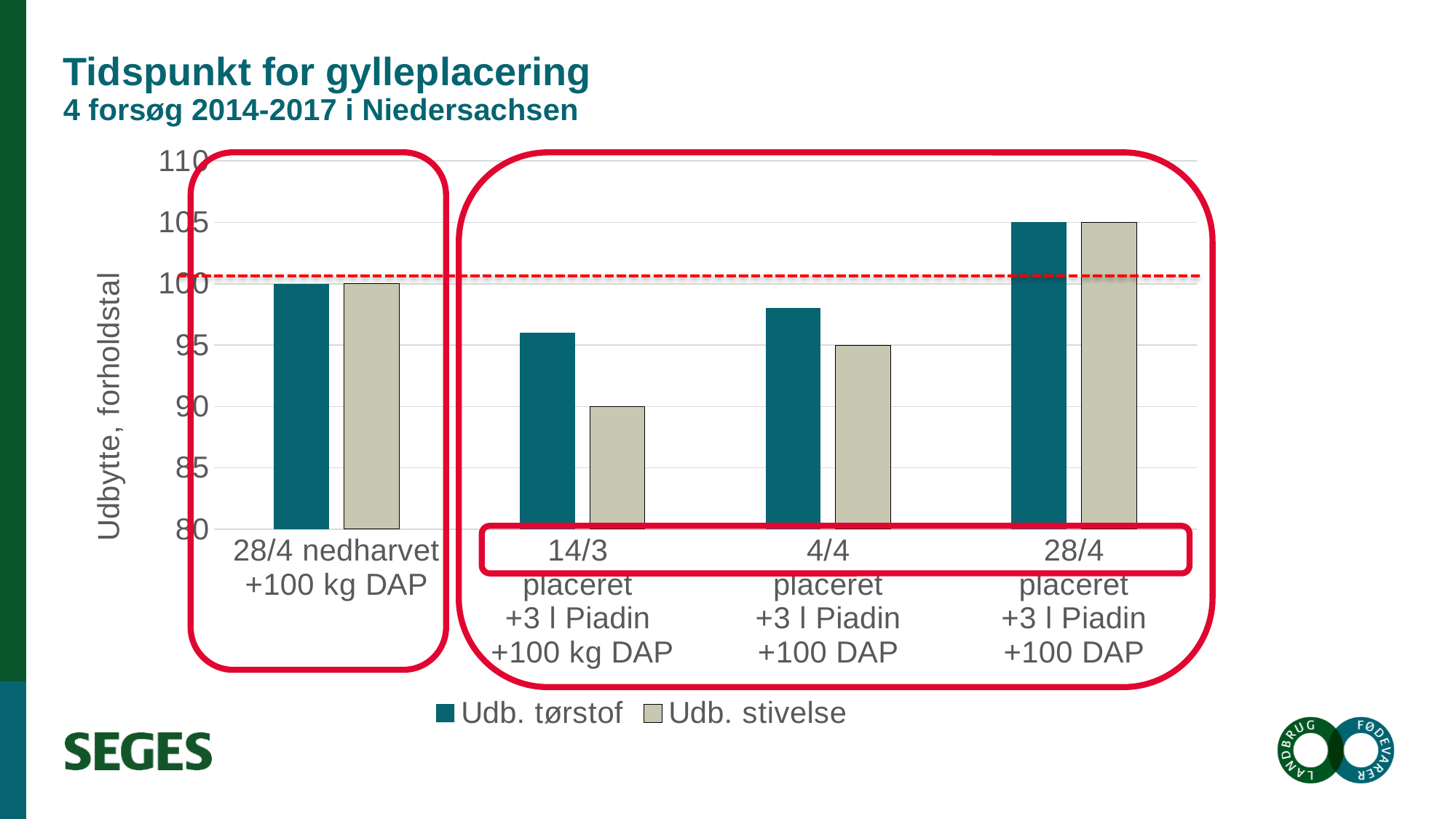
How many series does the legend list? 2 What is the value of Udb. stivelse for '14/3 placeret +3 l Piadin +100 kg DAP'? 90 Is the Udb. tørstof value for '14/3 placeret +3 l Piadin +100 kg DAP' greater or less than 100? less What kind of chart is shown on the slide? bar chart What is the value of Udb. tørstof for '28/4 placeret +3 l Piadin +100 DAP'? 105 Which category has the lowest Udb. stivelse value? 14/3 placeret +3 l Piadin +100 kg DAP How many categories are shown on the x axis? 4 What is the value of Udb. stivelse for '4/4 placeret +3 l Piadin +100 DAP'? 95 What is the value of Udb. tørstof for '28/4 nedharvet +100 kg DAP'? 100 Which category has the highest Udb. stivelse value? 28/4 placeret +3 l Piadin +100 DAP What is the difference between the Udb. stivelse values for '28/4 placeret +3 l Piadin +100 DAP' and '14/3 placeret +3 l Piadin +100 kg DAP'? 15 Which is larger for '4/4 placeret +3 l Piadin +100 DAP': Udb. tørstof or Udb. stivelse? Udb. tørstof